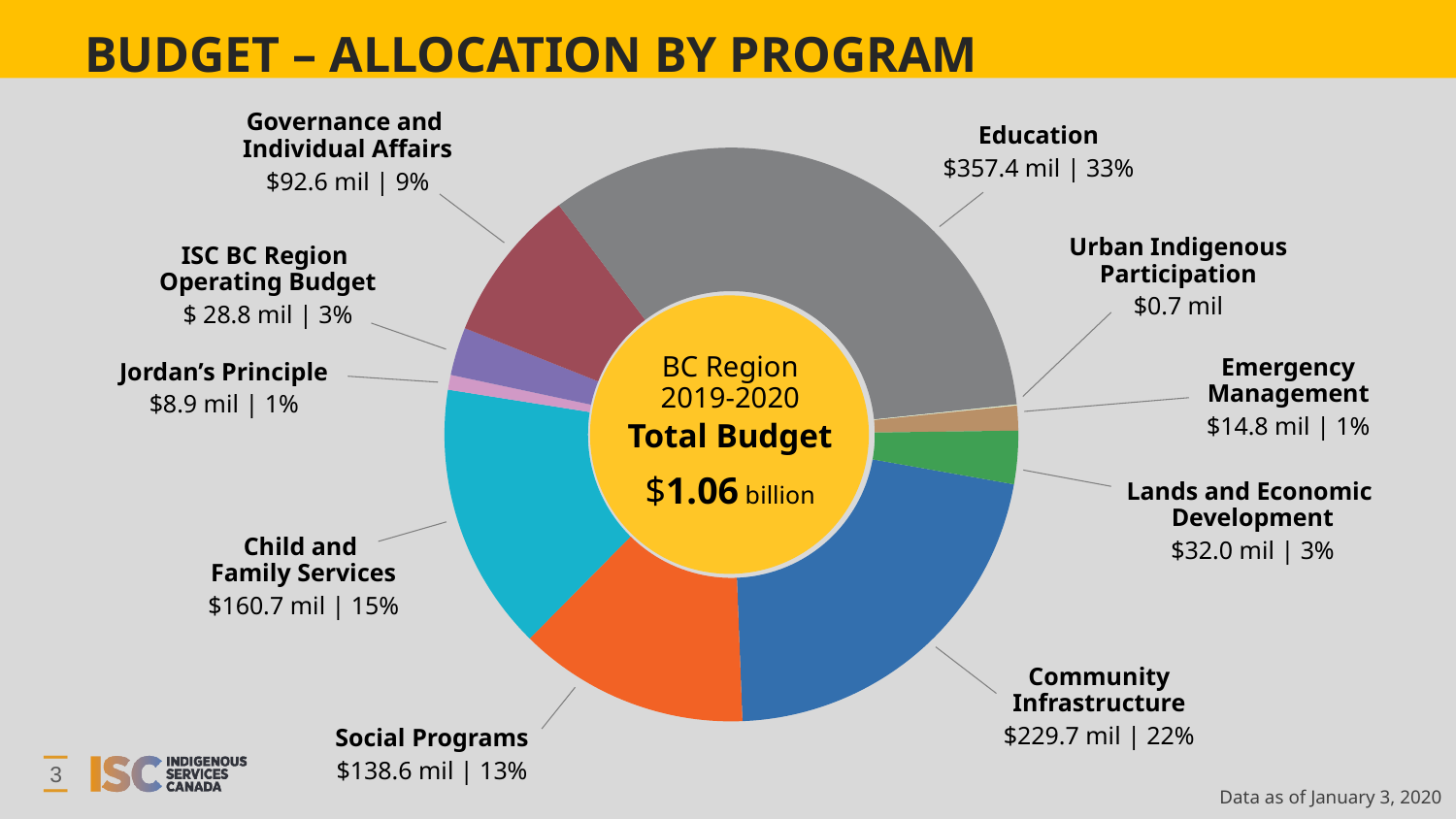
What is the budget allocation for Education? $357.4 mil Which program receives the smallest allocation? Urban Indigenous Participation What is the total budget shown in the centre of the chart? $1.06 billion Which receives more funding, Social Programs or Child and Family Services? Child and Family Services Which program receives the largest share of the budget? Education What is the difference in allocation between Education and Community Infrastructure? $127.7 mil What kind of chart is shown on the slide? Pie chart (donut) What is the allocation for Emergency Management? $14.8 mil What percentage of the budget goes to Governance and Individual Affairs? 9% What percentage of the budget goes to Community Infrastructure? 22% What is the budget allocation for Child and Family Services? $160.7 mil How many programs are shown in the chart? 10